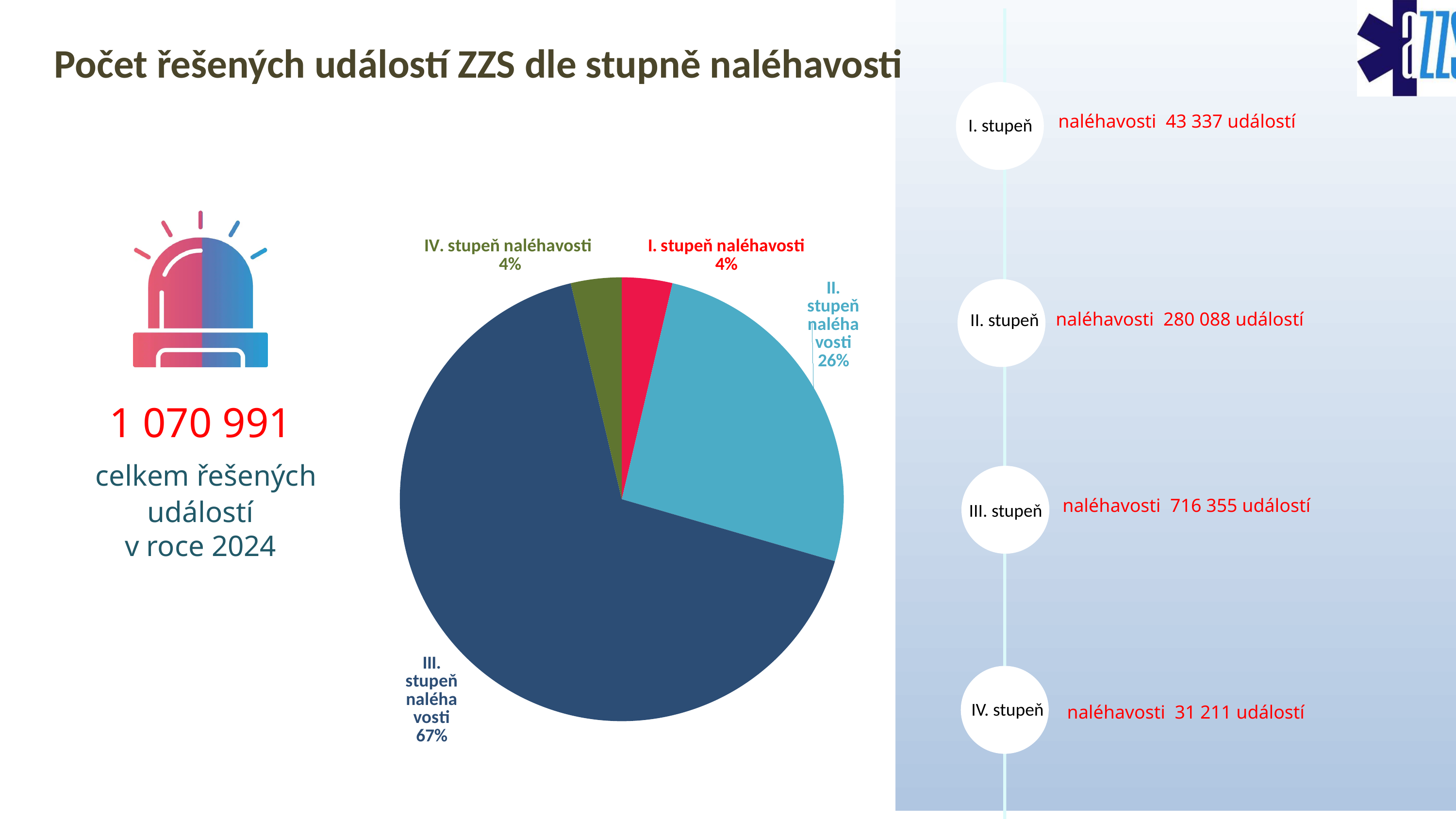
What percentage is shown for IV. stupeň naléhavosti? 4% Which category has the largest slice of the pie? III. stupeň naléhavosti Which is larger, the slice for II. stupeň naléhavosti or the slice for IV. stupeň naléhavosti? II. stupeň naléhavosti What is the title of the slide containing the pie chart? Počet řešených událostí ZZS dle stupně naléhavosti What share of the pie does III. stupeň naléhavosti represent? 67% What kind of chart is shown on the slide? pie chart How many slices does the pie chart have? 4 Which is larger, the slice for II. stupeň naléhavosti or the slice for III. stupeň naléhavosti? III. stupeň naléhavosti What share of the pie does II. stupeň naléhavosti represent? 26% What is the difference in percentage points between III. stupeň naléhavosti and II. stupeň naléhavosti? 41% What is the combined share of I. stupeň naléhavosti and IV. stupeň naléhavosti? 8% What percentage is shown for I. stupeň naléhavosti? 4%